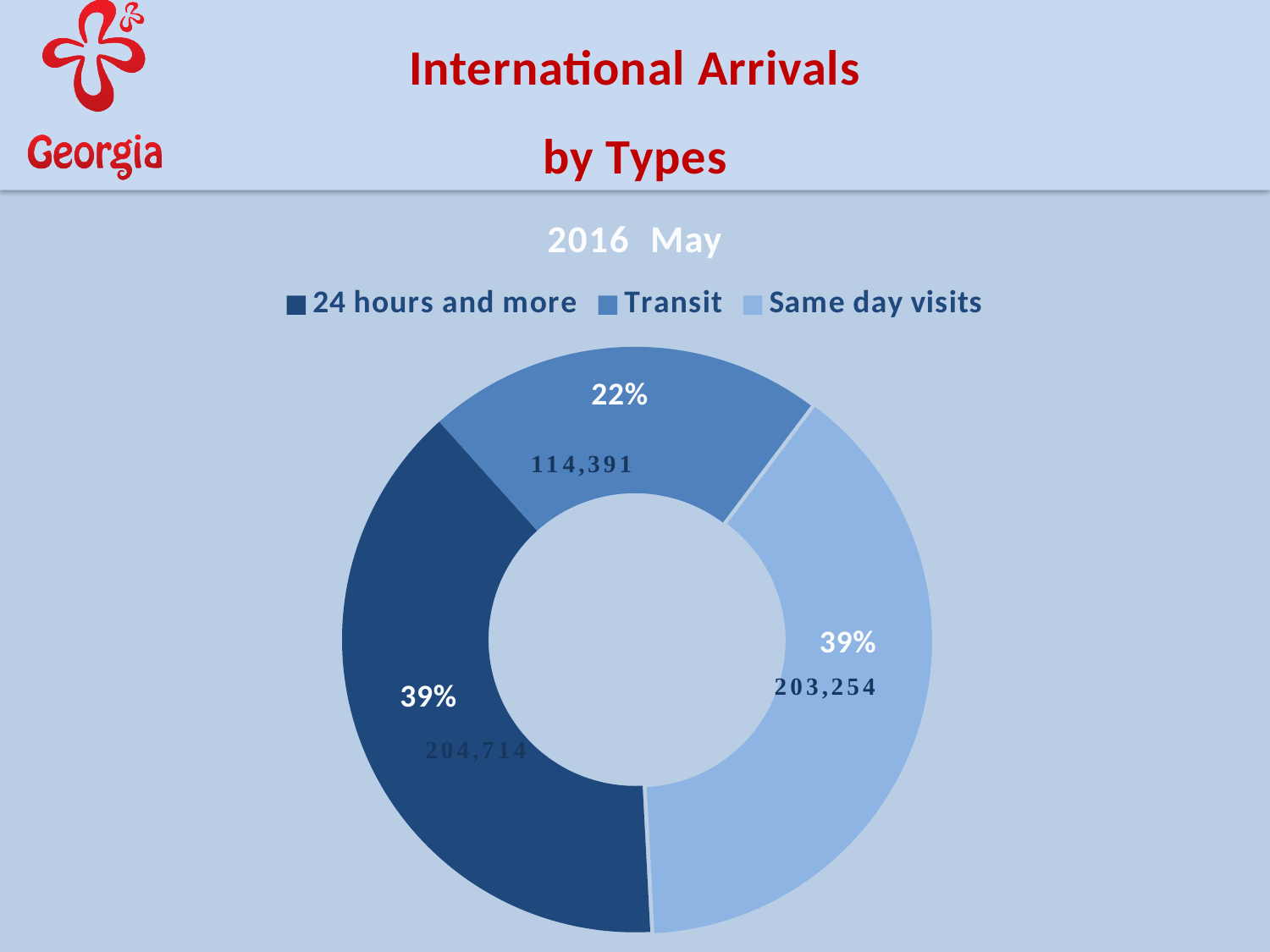
Which category has the smallest share of the chart? Transit What is the difference between the values for Same day visits and Transit? 88,863 What share of the chart does Same day visits represent? 39% Which is larger, the value for Transit or the value for Same day visits? Same day visits What is the value for 24 hours and more? 204,714 What kind of chart is shown on the slide? Doughnut (pie) chart What share of the chart does Transit represent? 22% How many categories does the chart show? 3 What is the value for Transit? 114,391 What is the value for Same day visits? 203,254 Which month and year does the chart cover? 2016 May What is the difference between the values for 24 hours and more and Transit? 90,323